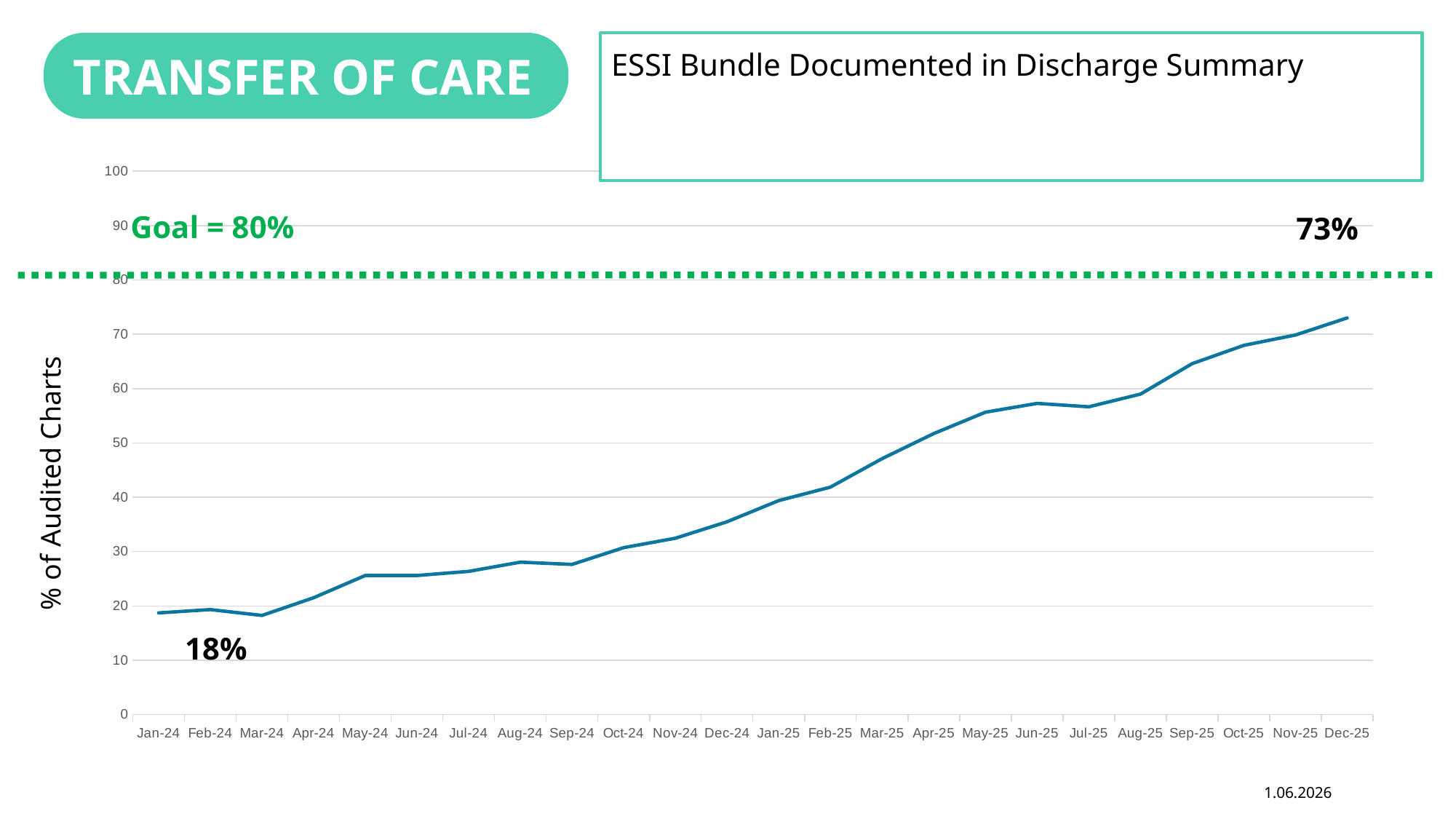
How many months are plotted along the x axis? 24 Do the values generally rise or fall from Jan-24 to Dec-25? rise What is the lowest value labeled on the chart? 18% What kind of chart is shown on the slide? line chart Which is larger, the value for Dec-25 or the value for Jan-24? Dec-25 Which month has the highest value on the chart? Dec-25 Is the value for Jun-25 greater or less than 50? greater What is the goal value shown on the chart? 80% Is the value for Jan-24 greater or less than 20? less Is the value for Dec-24 greater or less than 30? greater What value is labeled at the end of the line for Dec-25? 73% What is the title of the chart? ESSI Bundle Documented in Discharge Summary